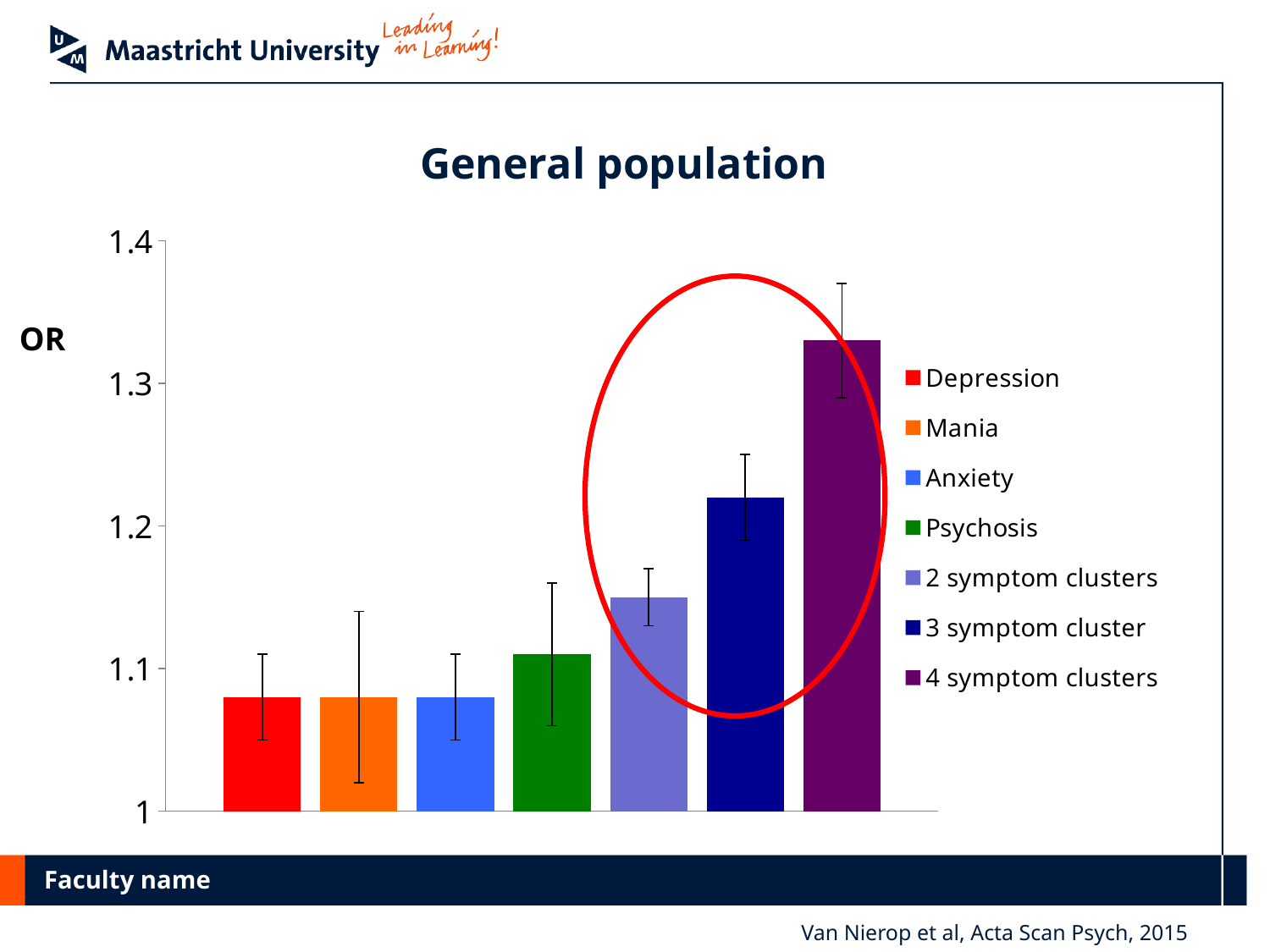
Which category has the highest OR value? 4 symptom clusters Which is larger, the value for 4 symptom clusters or the value for 3 symptom cluster? 4 symptom clusters Which is larger, the value for 2 symptom clusters or the value for Anxiety? 2 symptom clusters Is the value for 4 symptom clusters greater or less than 1.3? greater Is the value for 3 symptom cluster greater or less than 1.3? less How many entries does the legend list? 7 What kind of chart is shown on the slide? bar chart How many bars are plotted in the chart? 7 What is the title of the chart? General population Is the value for 2 symptom clusters greater or less than 1.2? less Do the bar values generally rise or fall from left to right across the chart? rise